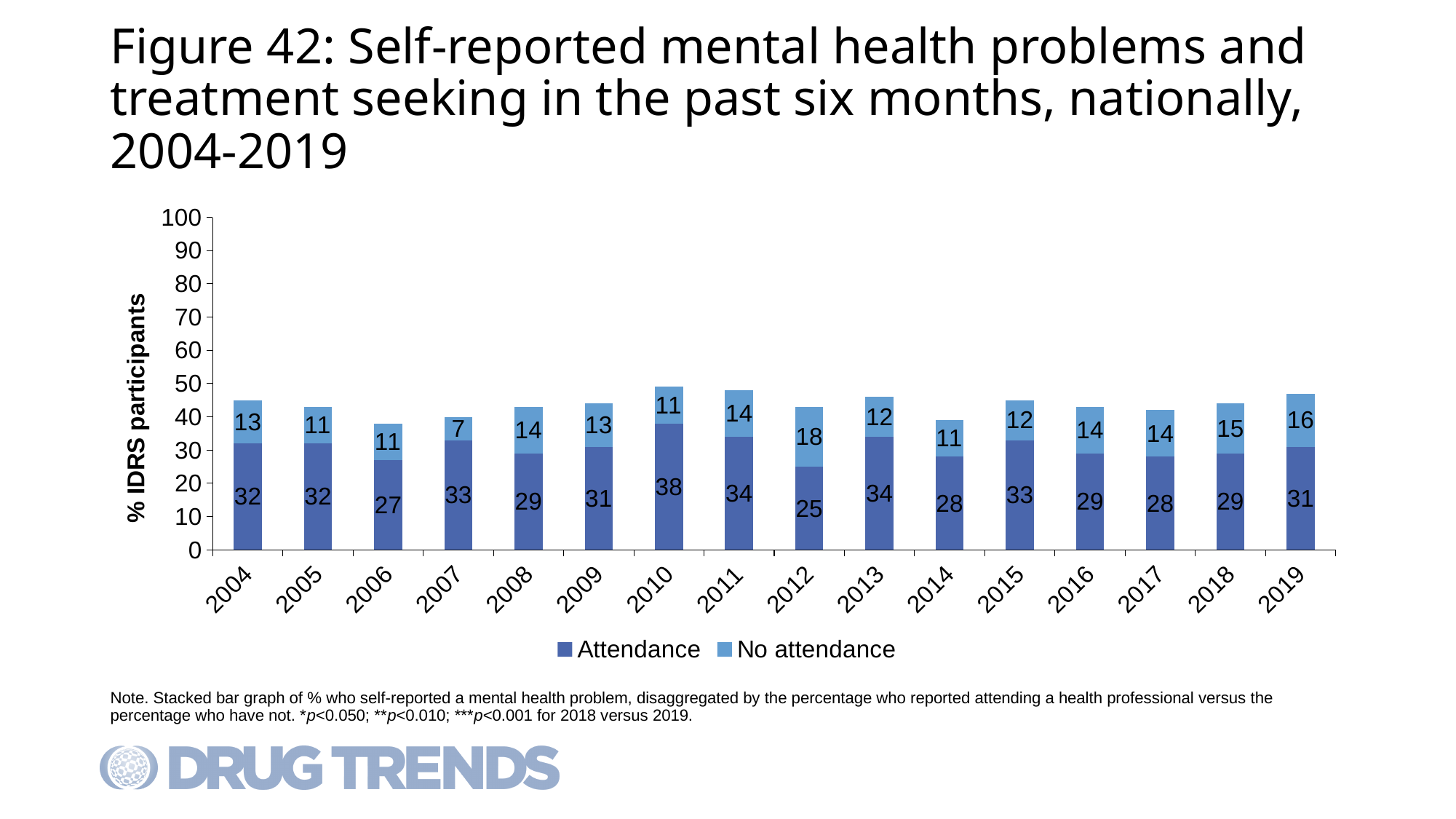
What is the total of the stacked bar for 2006? 38 What is the total of the stacked bar for 2019? 47 What is the No attendance value for 2012? 18 What is the Attendance value for 2010? 38 Which year has the highest Attendance value? 2010 What kind of chart is shown on the slide? Stacked bar chart What is the Attendance value for 2019? 31 Which year has the lowest No attendance value? 2007 How many years are shown on the x axis? 16 How many series does the legend list? 2 What is the difference between the Attendance values for 2010 and 2012? 13 Which is larger, the No attendance value for 2018 or for 2019? 2019